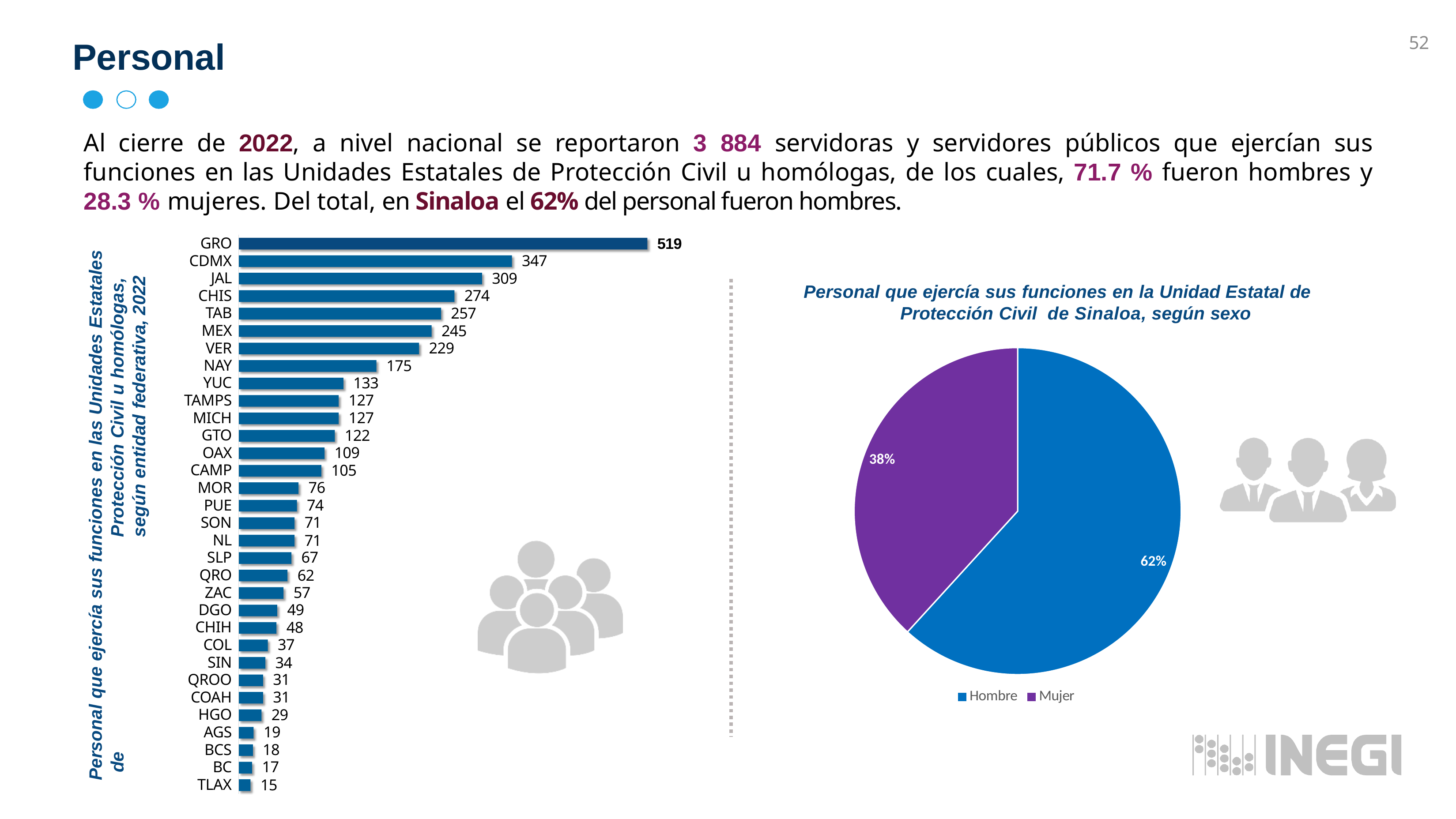
In the bar chart on the left, what is the difference between the values for CDMX and JAL? 38 In the pie chart on the right, what share is Mujer? 38% In the bar chart on the left, which entity has the lowest value? TLAX In the pie chart on the right, what share is Hombre? 62% How many entries does the legend of the pie chart on the right list? 2 In the bar chart on the left, what is the value for GRO? 519 What kind of chart is the chart on the left of the slide? Bar chart In the bar chart on the left, which entity has the highest value? GRO In the bar chart on the left, what is the value for SIN? 34 How many entities are shown in the bar chart on the left? 32 What is the title of the pie chart on the right? Personal que ejercía sus funciones en la Unidad Estatal de Protección Civil de Sinaloa, según sexo In the bar chart on the left, which is larger, the value for TAB or the value for MEX? TAB